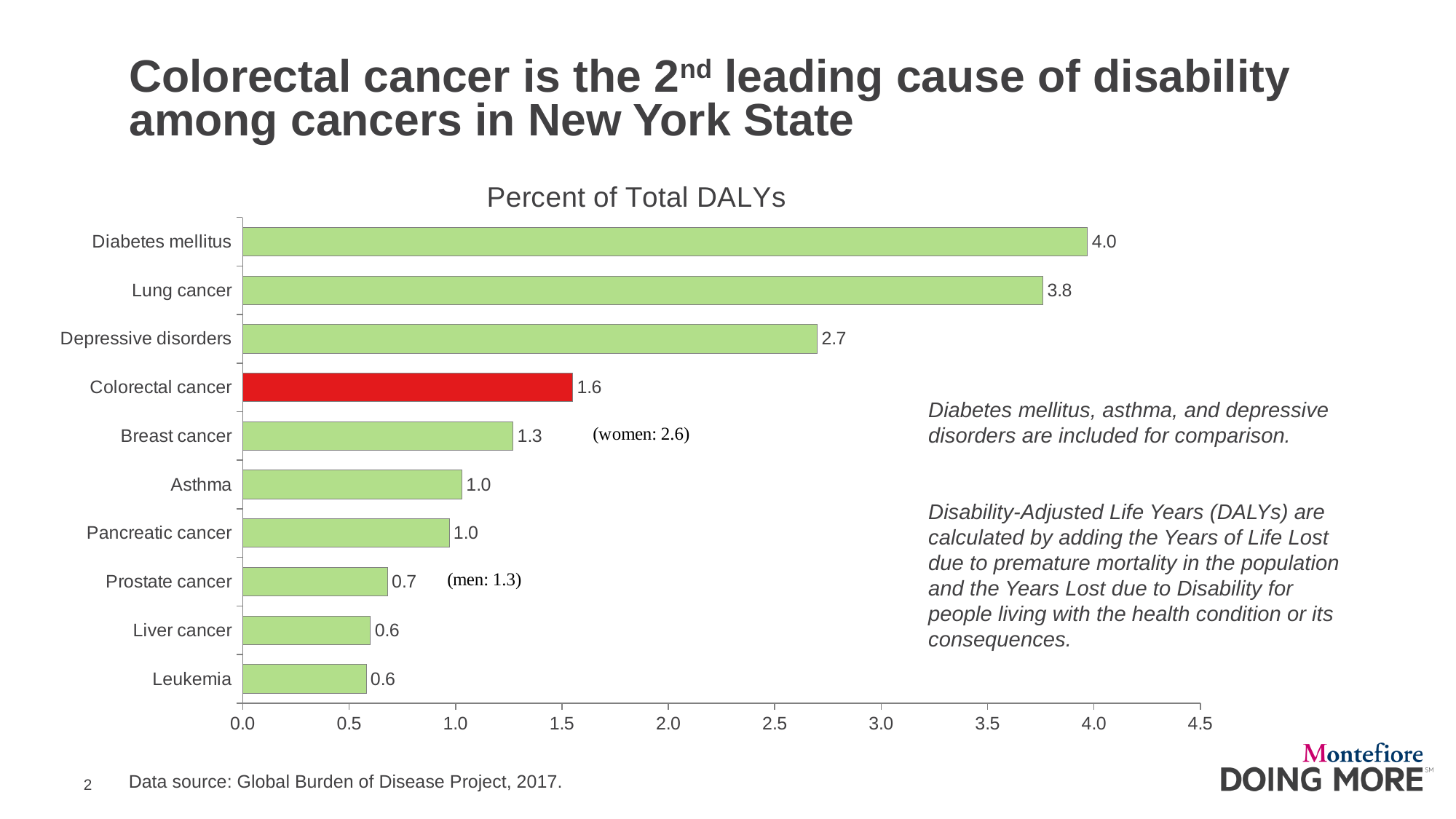
Is the value for Depressive disorders greater or less than 2.5? greater What kind of chart is shown on the slide? Bar chart How many categories are shown in the chart? 10 What is the title of the chart? Percent of Total DALYs What is the difference between the values for Diabetes mellitus and Colorectal cancer? 2.4 What is the value for Colorectal cancer? 1.6 Which is larger, the value for Breast cancer or the value for Prostate cancer? Breast cancer What is the difference between the values for Lung cancer and Depressive disorders? 1.1 What is the value for Depressive disorders? 2.7 Which bar is coloured red rather than green? Colorectal cancer What is the value for Lung cancer? 3.8 Which category has the highest value? Diabetes mellitus